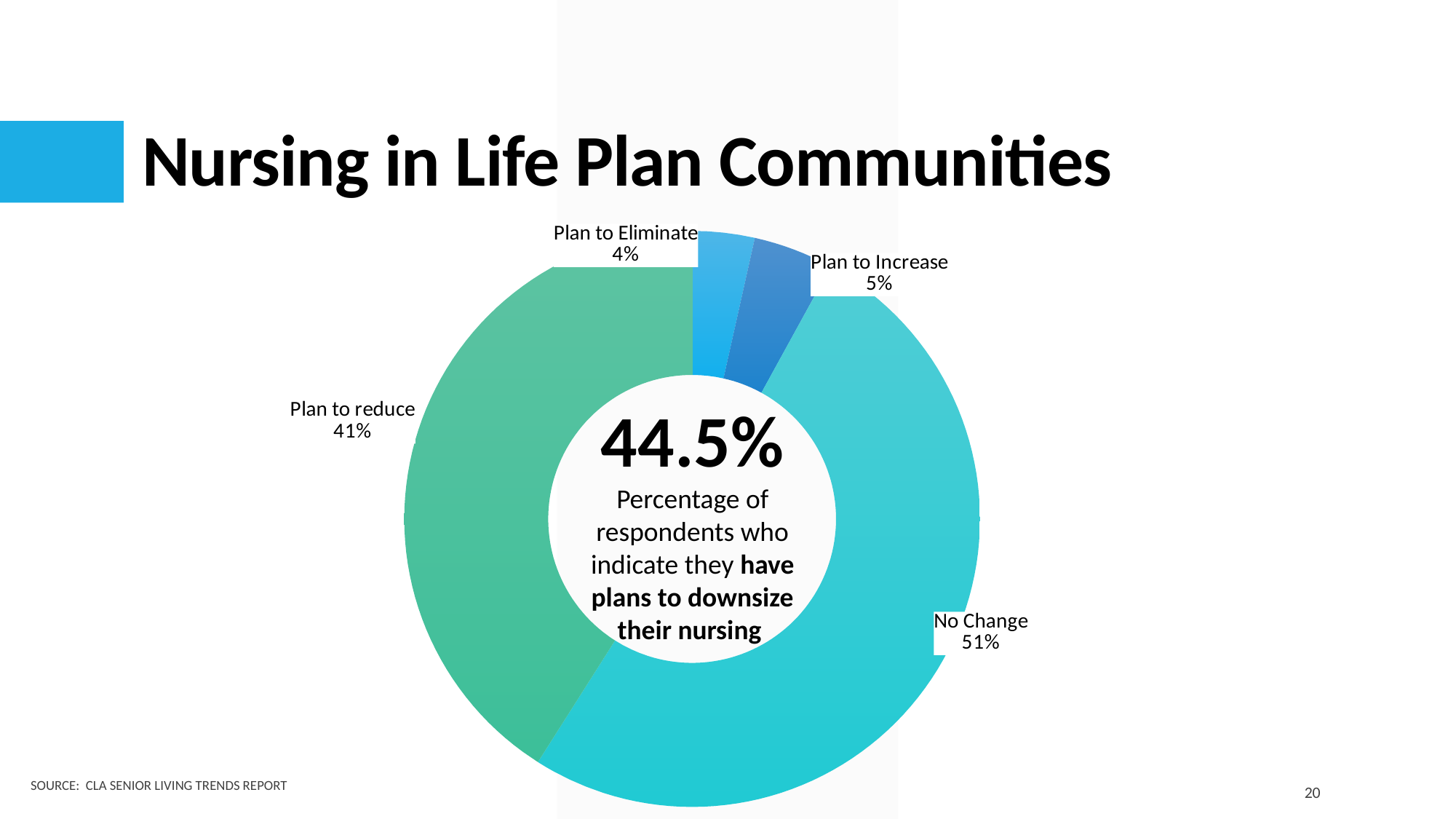
Which category has the smallest share of the chart? Plan to Eliminate What percentage of respondents 'Plan to reduce' nursing? 41% Which is larger, the share for 'Plan to Increase' or 'Plan to Eliminate'? Plan to Increase What large percentage is printed in the centre of the chart? 44.5% How many categories are shown in the chart? 4 What percentage of respondents 'Plan to Eliminate' nursing? 4% Which category has the largest share of the chart? No Change What is the difference in percentage points between 'No Change' and 'Plan to reduce'? 10 What percentage of respondents indicated 'No Change' for nursing in life plan communities? 51% What is the combined share of 'Plan to reduce' and 'Plan to Eliminate'? 45% What kind of chart is shown on the slide? Pie chart (donut) What percentage of respondents 'Plan to Increase' nursing? 5%